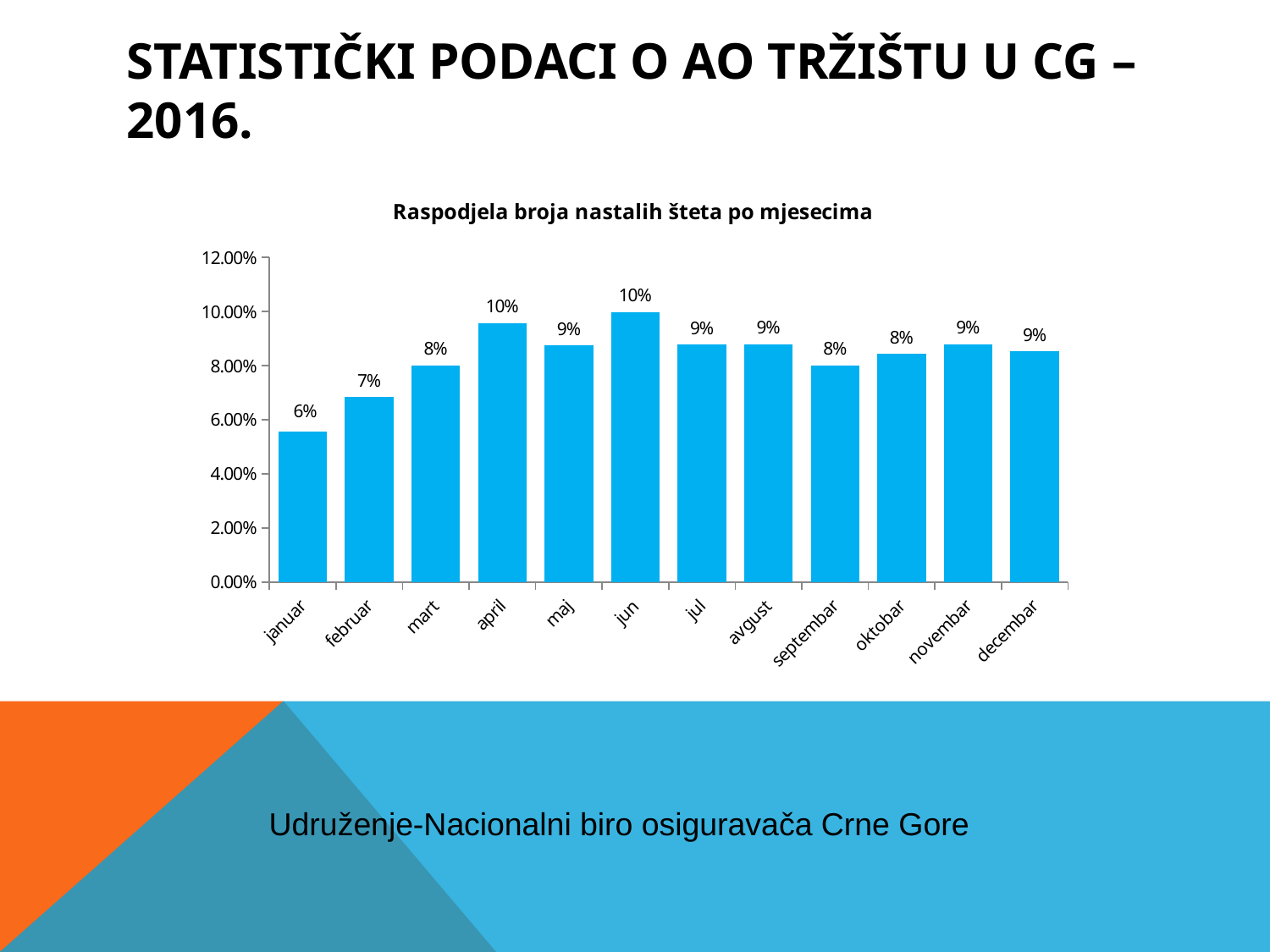
Which is larger, the value for februar or the value for mart? mart What kind of chart is shown on the slide? bar chart Is the value for jun greater or less than 8.00%? greater What is the difference between the values for april and januar? 4% What is the value for januar? 6% Do the values rise or fall from januar to april? rise What is the value for septembar? 8% How many months are shown on the x axis? 12 Which month has the lowest value? januar What is the value for april? 10% What is the title of the chart? Raspodjela broja nastalih šteta po mjesecima Is the value for januar greater or less than 4.00%? greater